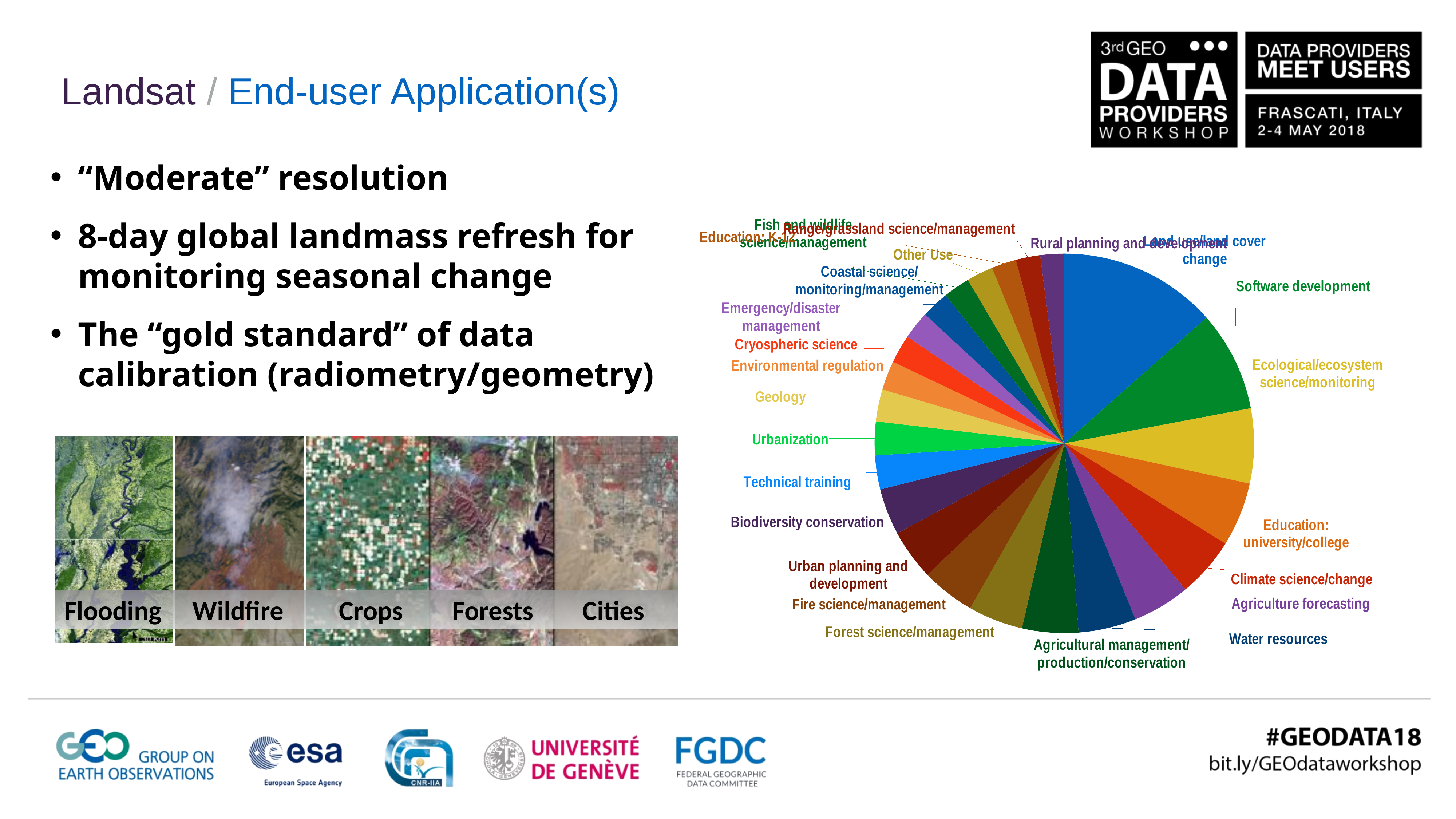
What colour is the Software development slice in the pie chart? green In the pie chart, which slice is larger: Ecological/ecosystem science/monitoring or Technical training? Ecological/ecosystem science/monitoring What kind of chart is shown on the right side of the slide? pie chart In the pie chart, which slice is larger: Land use/land cover change or Water resources? Land use/land cover change In the pie chart, which slice is larger: Software development or Geology? Software development Which category has the largest slice in the pie chart? Land use/land cover change What colour is the Land use/land cover change slice in the pie chart? blue